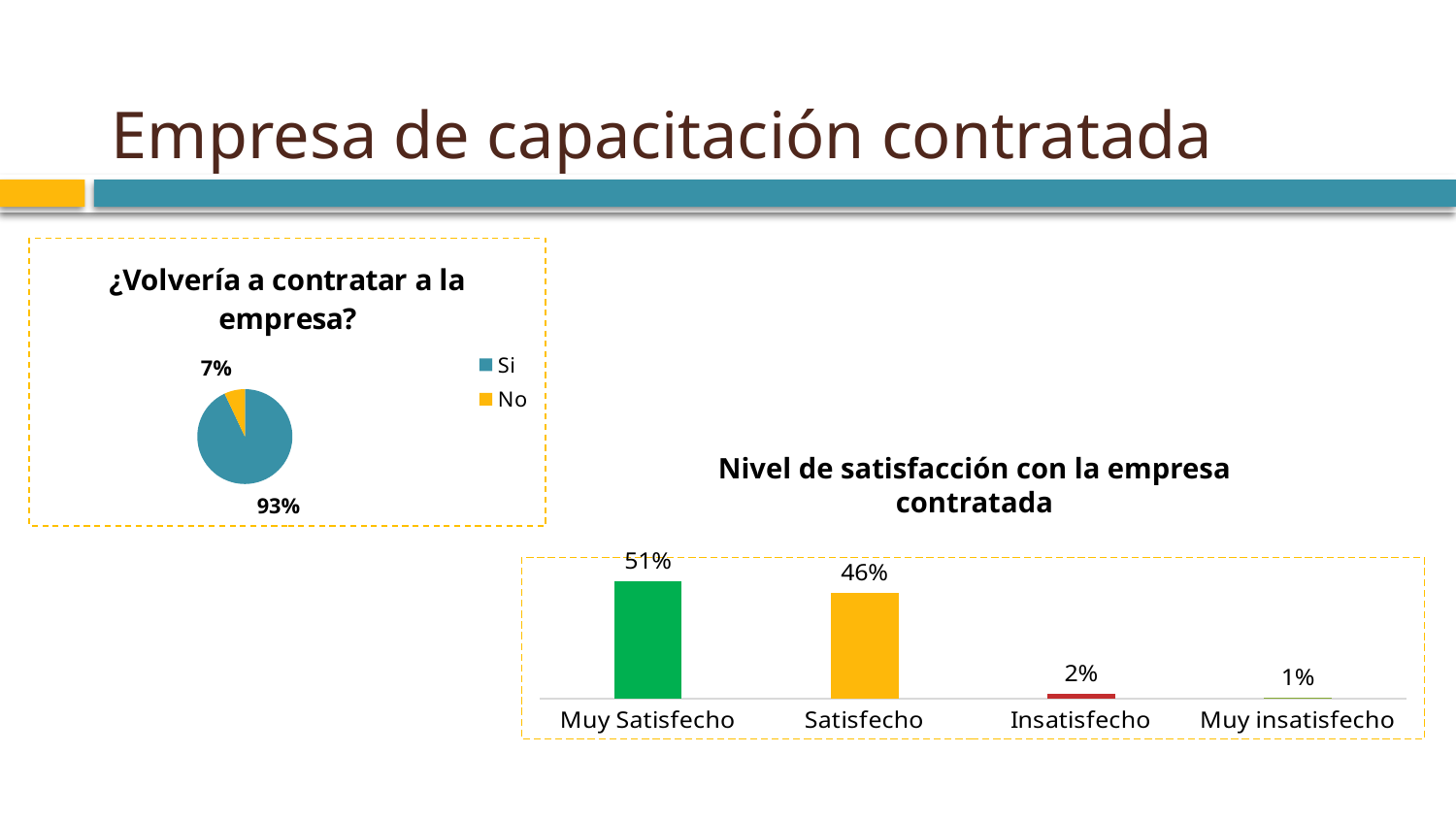
In the pie chart '¿Volvería a contratar a la empresa?', which colour represents No? Yellow In the chart 'Nivel de satisfacción con la empresa contratada', what is the value for Muy Satisfecho? 51% What kind of chart is 'Nivel de satisfacción con la empresa contratada'? Bar chart In the chart 'Nivel de satisfacción con la empresa contratada', what is the difference between Muy Satisfecho and Satisfecho? 5% In the chart 'Nivel de satisfacción con la empresa contratada', which category has the lowest value? Muy insatisfecho In the chart 'Nivel de satisfacción con la empresa contratada', which category has the highest value? Muy Satisfecho In the pie chart '¿Volvería a contratar a la empresa?', what share of respondents answered Si? 93% In the chart 'Nivel de satisfacción con la empresa contratada', what is the value for Satisfecho? 46% In the pie chart '¿Volvería a contratar a la empresa?', how many entries does the legend list? 2 In the chart 'Nivel de satisfacción con la empresa contratada', how many categories are shown? 4 In the chart 'Nivel de satisfacción con la empresa contratada', what is the value for Insatisfecho? 2% In the pie chart '¿Volvería a contratar a la empresa?', what share of respondents answered No? 7%